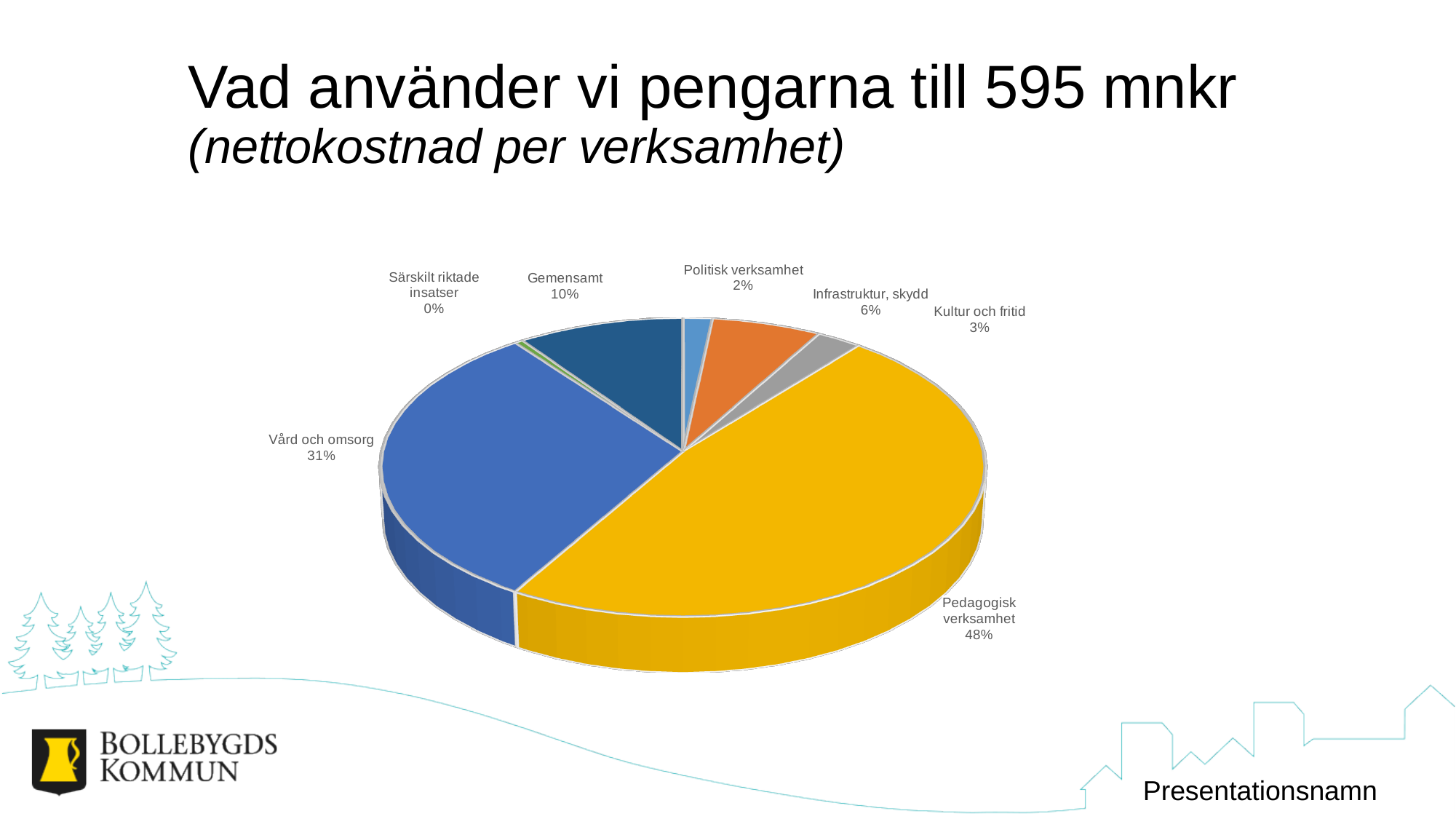
What type of chart is shown on the slide? Pie chart How many categories are shown in the pie chart? 7 Which category has the largest slice of the pie? Pedagogisk verksamhet Which is larger, the share for Infrastruktur, skydd or the share for Kultur och fritid? Infrastruktur, skydd What share of the pie does Pedagogisk verksamhet represent? 48% What percentage is shown for Kultur och fritid? 3% What percentage is shown for Vård och omsorg? 31% What percentage is shown for Särskilt riktade insatser? 0% What is the difference in percentage points between Pedagogisk verksamhet and Vård och omsorg? 17 What percentage is shown for Gemensamt? 10% What percentage is shown for Infrastruktur, skydd? 6% Which category has the smallest slice of the pie? Särskilt riktade insatser